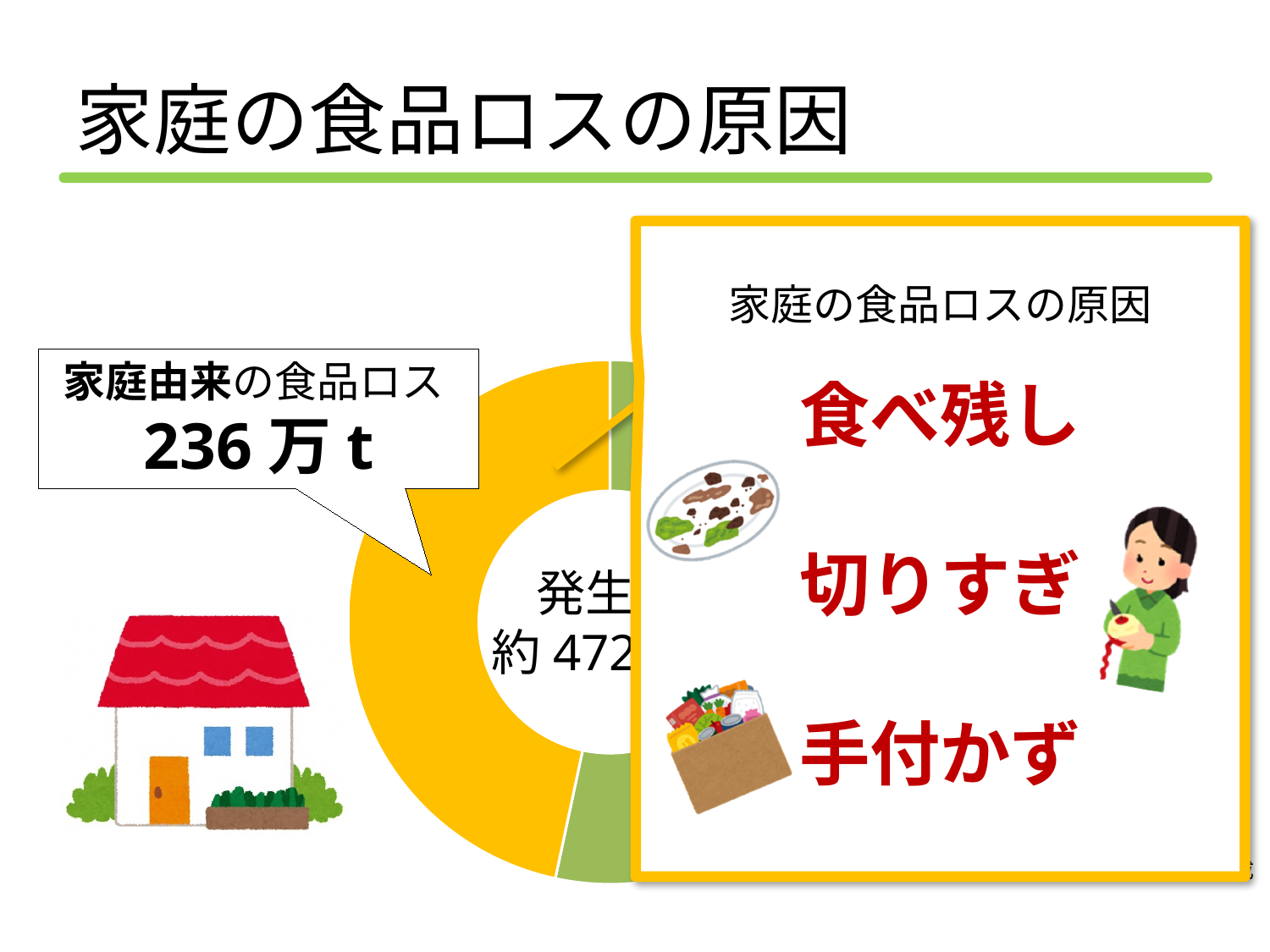
What is the value shown for 家庭由来の食品ロス in the chart's callout? 236万t Which slice does the callout box reading 236万t point to? 家庭由来の食品ロス What kind of chart is shown on the slide? doughnut chart What colour is the slice labelled 家庭由来の食品ロス? yellow